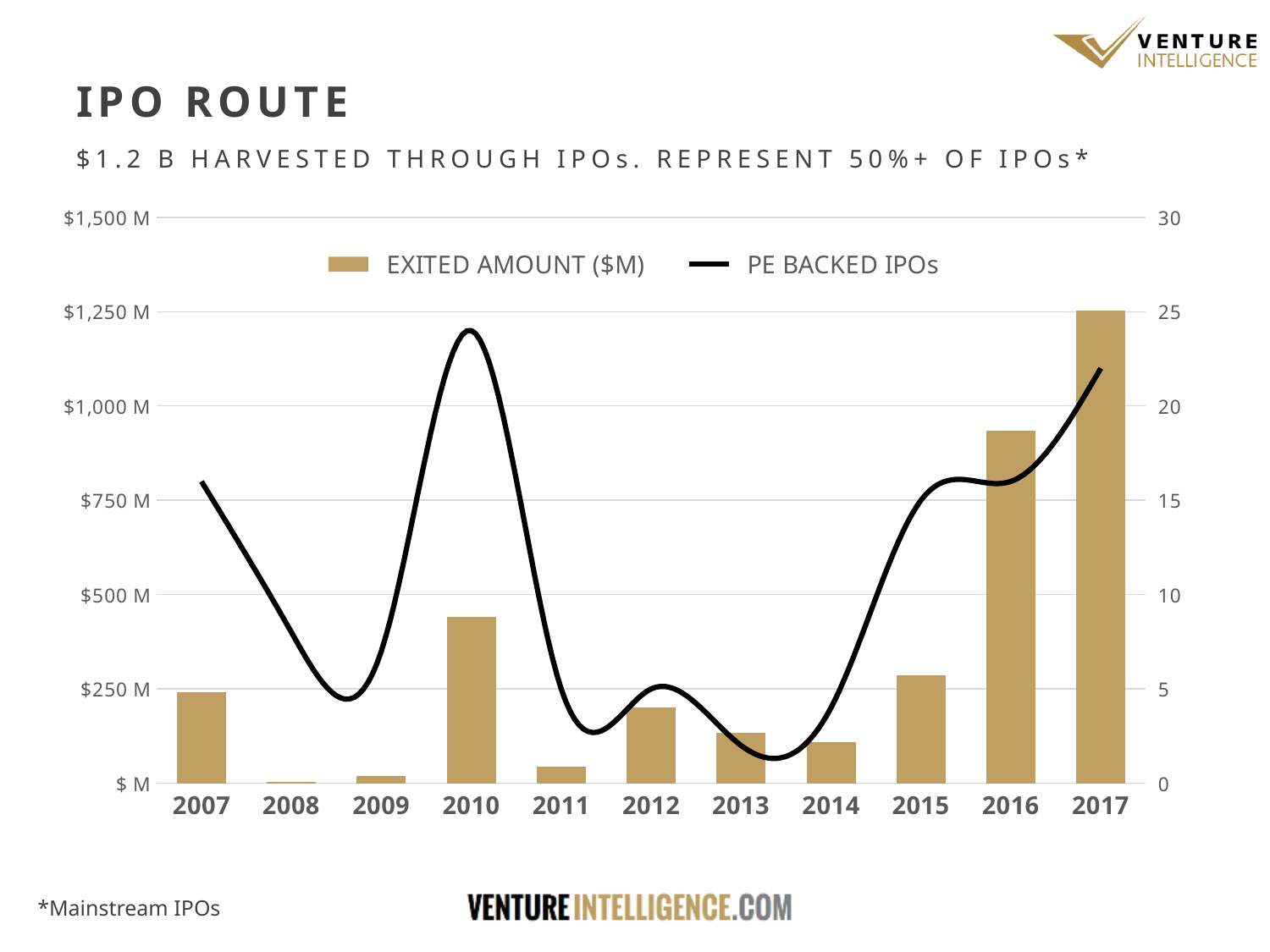
How many series does the legend list? 2 How many years are shown on the x axis? 11 Is the exited amount for 2016 greater or less than $750 M? greater Which year has the lowest exited amount? 2008 Is the exited amount for 2010 greater or less than $500 M? less Which year has the highest exited amount? 2017 Which year has the highest number of PE backed IPOs? 2010 Which is larger, the exited amount in 2012 or in 2014? 2012 Is the exited amount for 2015 greater or less than $250 M? greater What is the title of the chart? IPO ROUTE What kind of chart is shown on the slide? Combined bar and line chart